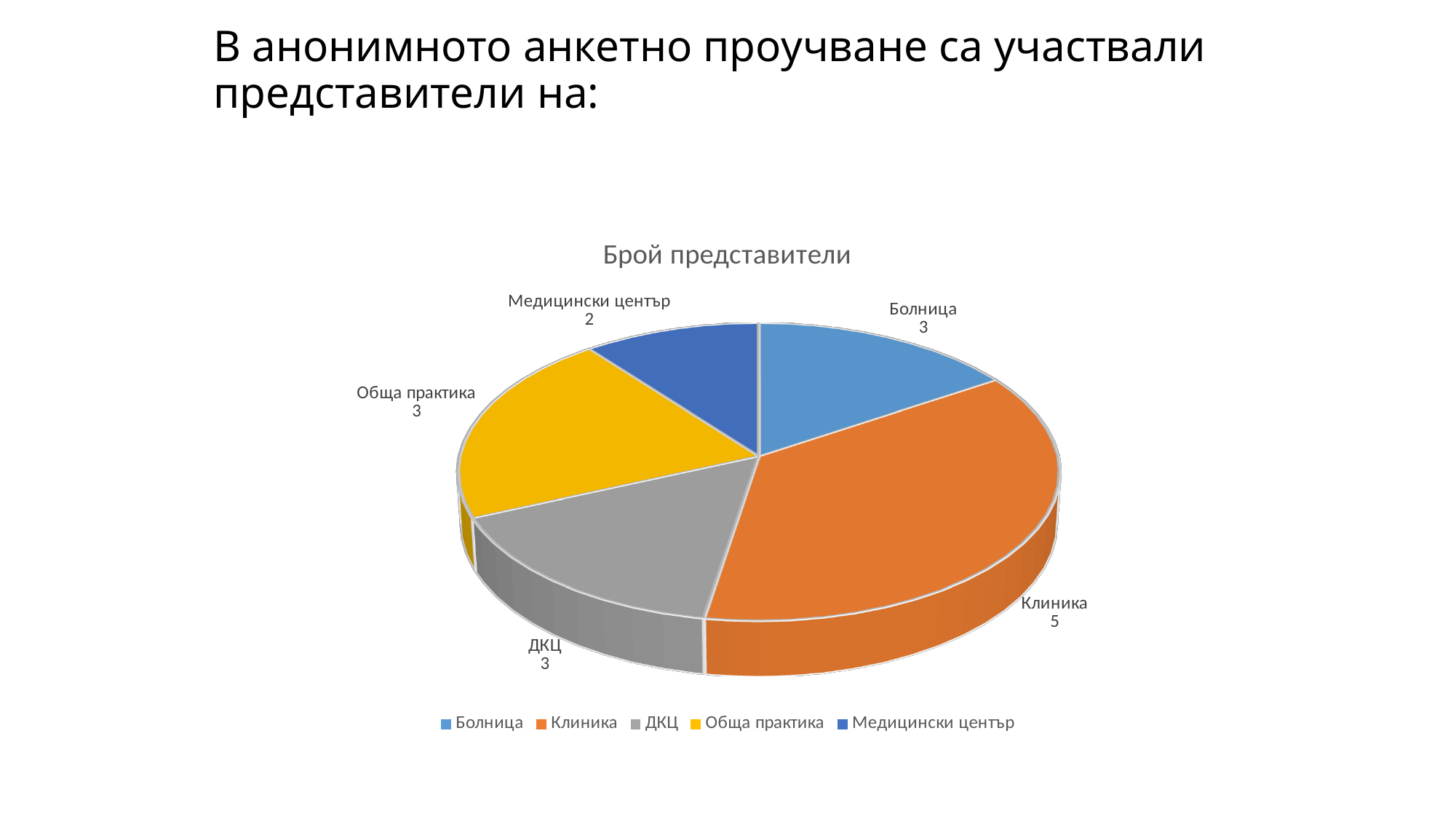
What is the value for Клиника? 5 What is the difference between the values for Клиника and Медицински център? 3 What is the value for Медицински център? 2 How many categories does the pie chart have? 5 Which category has the lowest value? Медицински център How many entries does the legend list? 5 What kind of chart is shown on the slide? pie chart Which category has the highest value? Клиника What is the value for Обща практика? 3 What is the title of the chart? Брой представители Which is larger, the value for Клиника or the value for Болница? Клиника